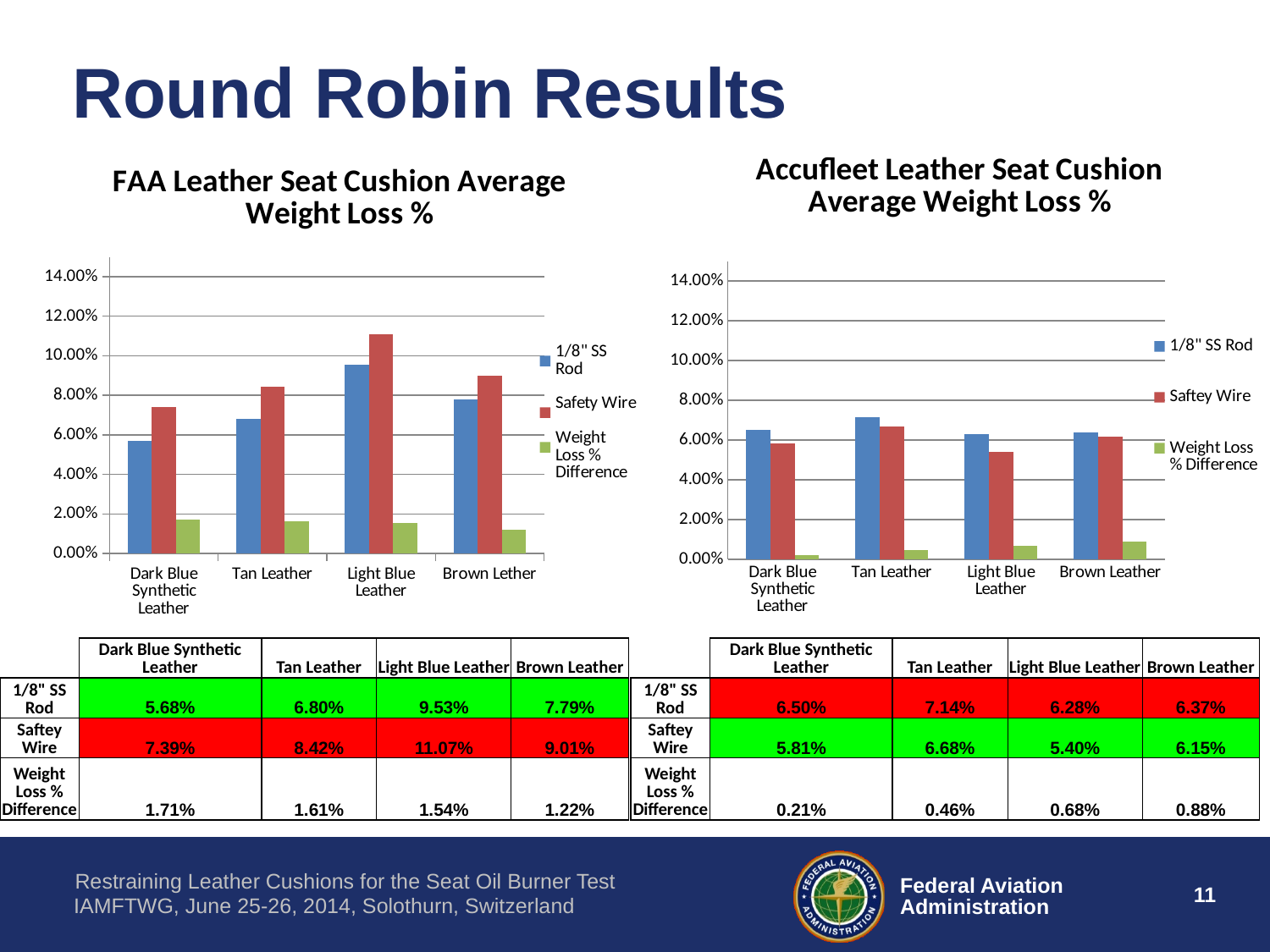
In the FAA Leather Seat Cushion chart, what is the Safety Wire value for Light Blue Leather? 11.07% In the FAA Leather Seat Cushion chart, what is the 1/8" SS Rod value for Dark Blue Synthetic Leather? 5.68% In the Accufleet Leather Seat Cushion chart, which category has the lowest Safety Wire value? Light Blue Leather In the Accufleet Leather Seat Cushion chart, does the Weight Loss % Difference rise or fall from Dark Blue Synthetic Leather to Brown Leather? rise How many series does the legend of the Accufleet Leather Seat Cushion chart list? 3 In the FAA Leather Seat Cushion chart, what is the difference between the Safety Wire and 1/8" SS Rod values for Tan Leather? 1.61% In the Accufleet Leather Seat Cushion chart, what is the 1/8" SS Rod value for Tan Leather? 7.14% In the FAA Leather Seat Cushion chart, which category has the highest Safety Wire value? Light Blue Leather In the Accufleet Leather Seat Cushion chart, what is the Weight Loss % Difference for Brown Leather? 0.88% In the Accufleet Leather Seat Cushion chart, is the 1/8" SS Rod value for Tan Leather greater or less than 6.00%? greater In the FAA Leather Seat Cushion chart, which category has the lowest 1/8" SS Rod value? Dark Blue Synthetic Leather What type of chart is the FAA Leather Seat Cushion Average Weight Loss % chart? bar chart